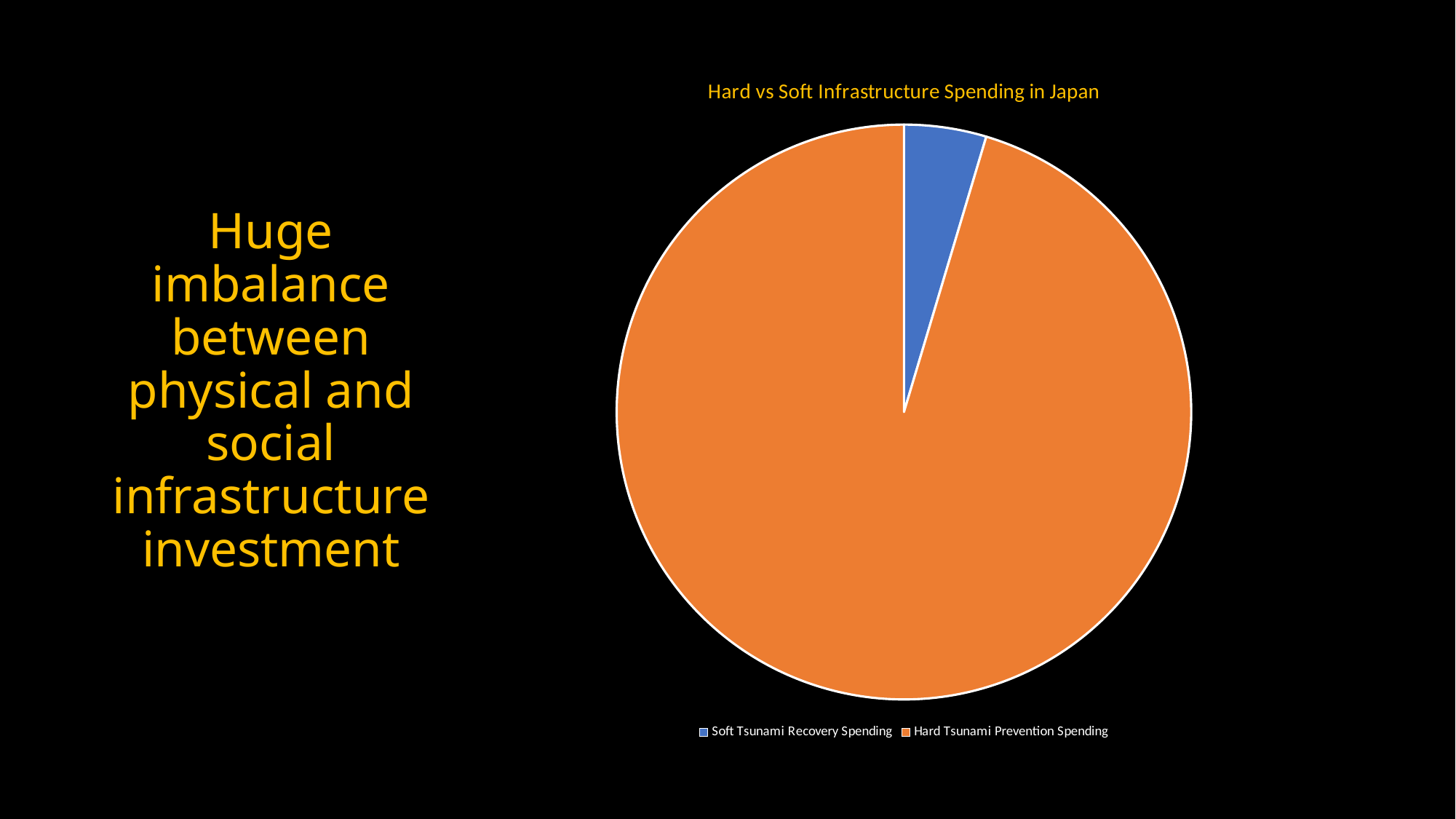
How many entries does the legend list? 2 What kind of chart is shown on the slide? pie chart Which is larger, Soft Tsunami Recovery Spending or Hard Tsunami Prevention Spending? Hard Tsunami Prevention Spending Which colour represents Soft Tsunami Recovery Spending in the chart? blue How many slices does the pie chart have? 2 Which category has the smallest slice of the pie? Soft Tsunami Recovery Spending What is the title of the chart? Hard vs Soft Infrastructure Spending in Japan Which category has the largest slice of the pie? Hard Tsunami Prevention Spending